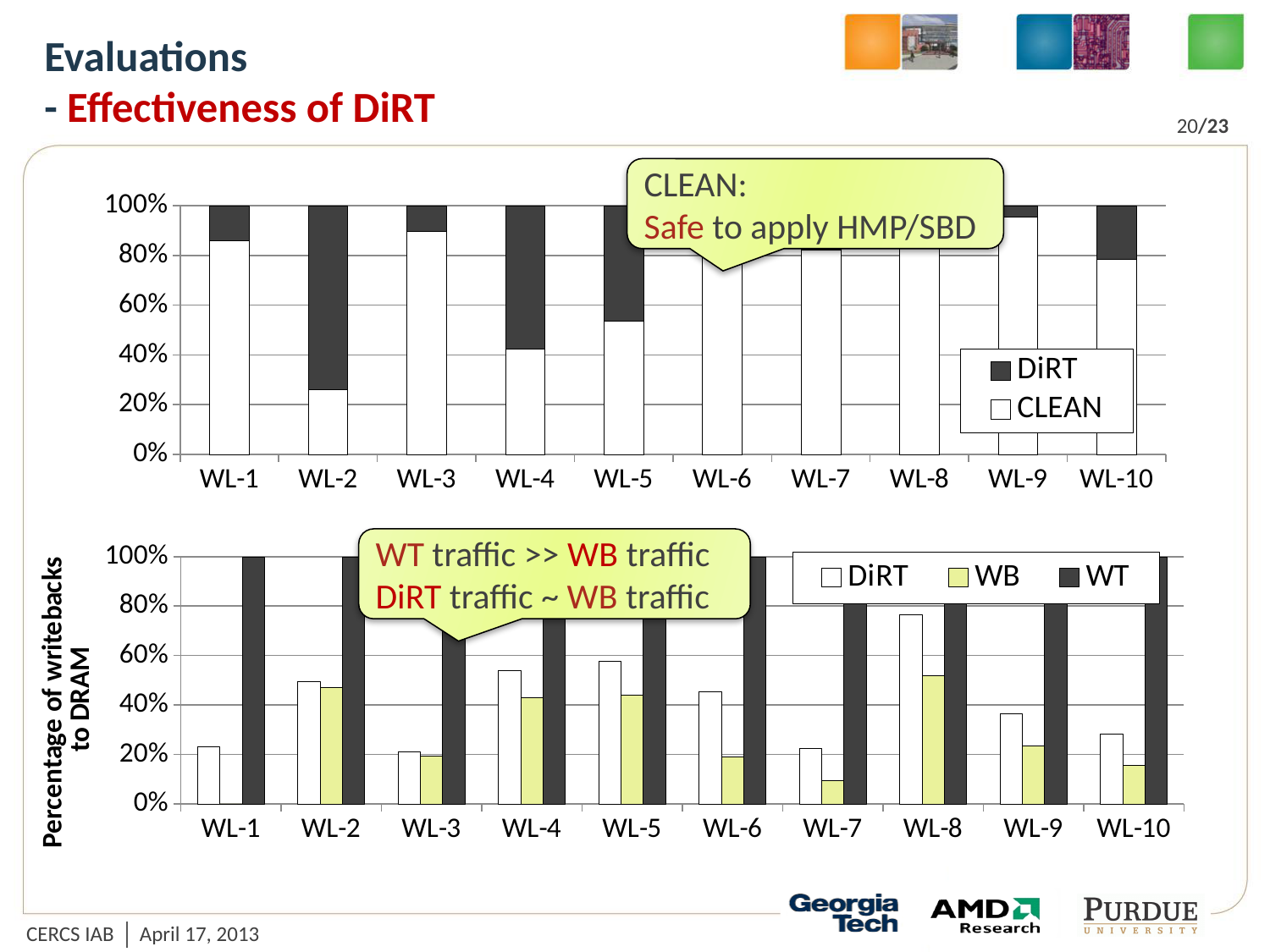
In the bottom chart, what is the WT value for WL-1? 100% In the top chart, what is the total height of the stacked bar for WL-1? 100% In the bottom chart, which is larger for WL-7, DiRT or WB? DiRT In the top chart, is the CLEAN value for WL-4 greater or less than 60%? less In the top chart, which workload has the smallest CLEAN share? WL-2 What is the y-axis title of the bottom chart? Percentage of writebacks to DRAM What kind of chart is the top chart on the slide? Stacked bar chart How many series does the legend of the top chart list? 2 How many workloads are shown on the x axis of the top chart? 10 In the bottom chart, is the DiRT value for WL-5 greater or less than 40%? greater How many series does the legend of the bottom chart list? 3 In the bottom chart, which workload has the highest DiRT value? WL-8